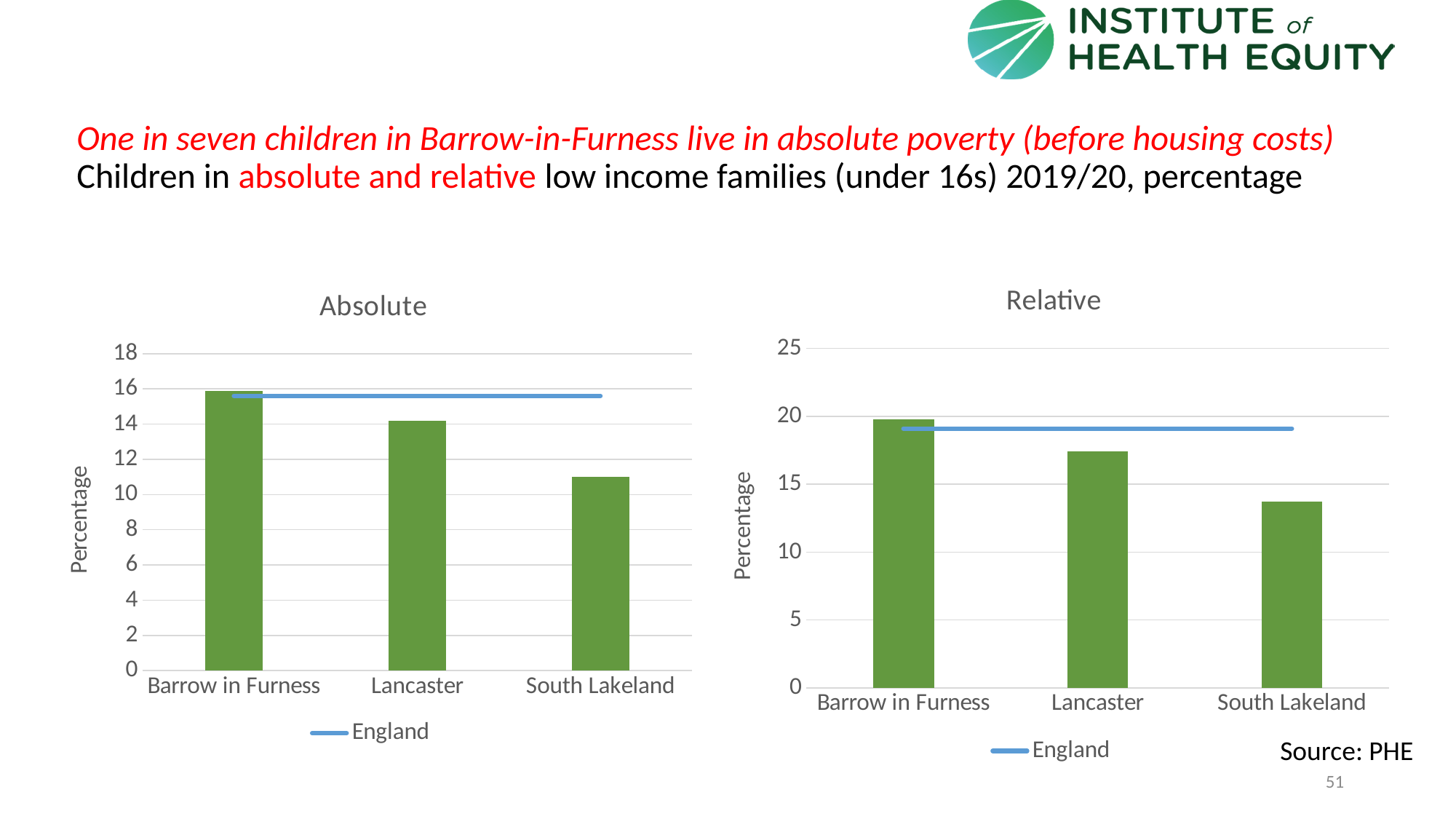
In the Absolute chart, which area has the highest percentage? Barrow in Furness What kind of chart is the Absolute chart? bar chart In the Absolute chart, which is larger, the value for Lancaster or the value for South Lakeland? Lancaster What does the blue horizontal line in the Absolute chart represent, according to the legend? England In the Relative chart, is the value for Lancaster greater or less than 15? greater In the Relative chart, do the bar values rise or fall from left to right? fall In the Absolute chart, is the value for South Lakeland greater or less than 12? less How many areas are shown as bars in the Relative chart? 3 In the Relative chart, is the value for South Lakeland greater or less than 15? less In the Relative chart, which area has the highest percentage? Barrow in Furness In the Absolute chart, which area has the lowest percentage? South Lakeland In the Relative chart, which area has the lowest percentage? South Lakeland